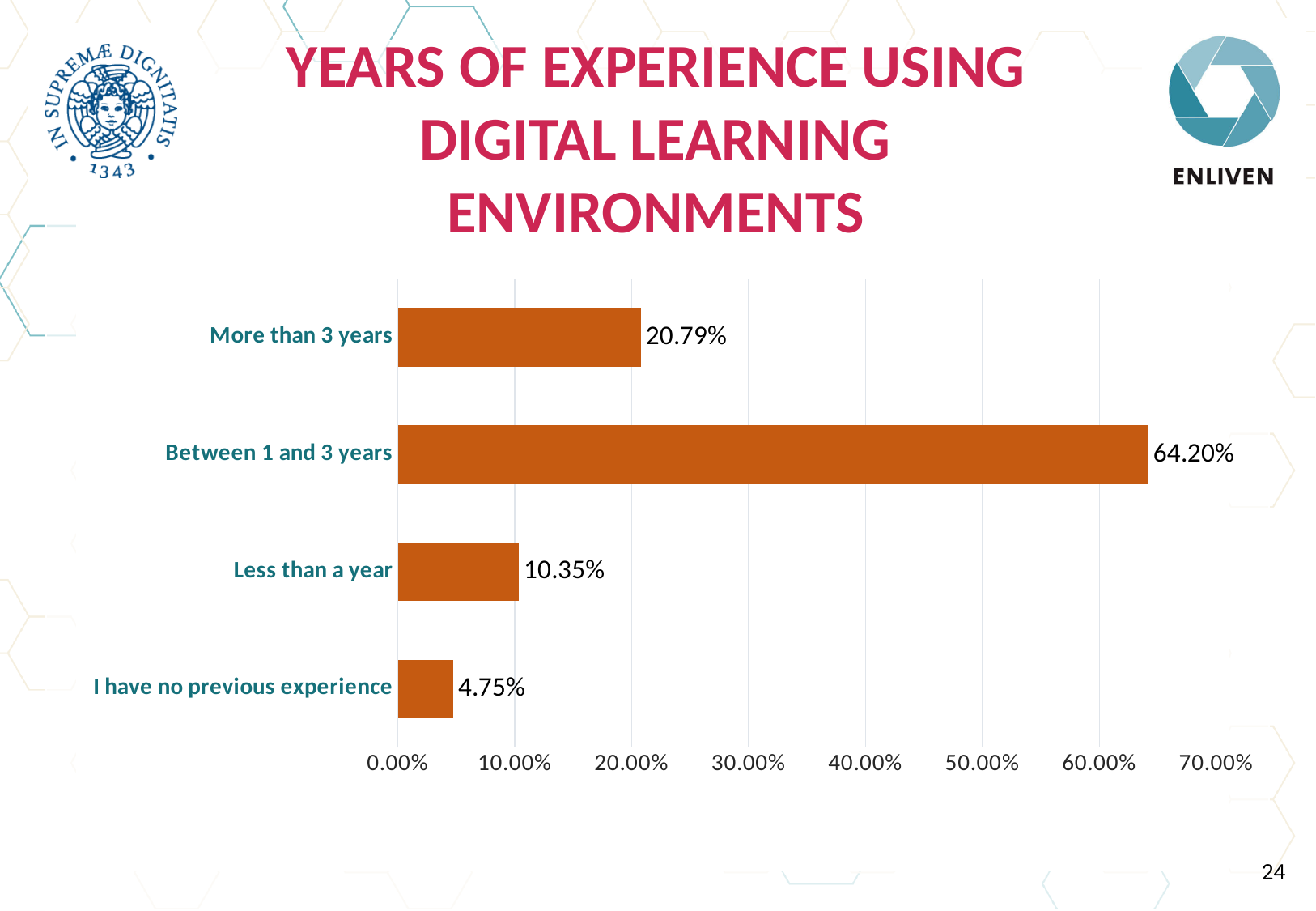
What kind of chart is shown on the slide? Bar chart What is the value for "I have no previous experience"? 4.75% What is the value for "Less than a year"? 10.35% What is the difference between the values for "Between 1 and 3 years" and "More than 3 years"? 43.41% Which is larger, the value for "More than 3 years" or the value for "Less than a year"? More than 3 years Which category has the highest value? Between 1 and 3 years Is the value for "Between 1 and 3 years" greater or less than 60.00%? greater What is the value for "More than 3 years"? 20.79% How many categories are shown in the chart? 4 Which category has the lowest value? I have no previous experience What is the value for "Between 1 and 3 years"? 64.20% What is the difference between the values for "Less than a year" and "I have no previous experience"? 5.60%